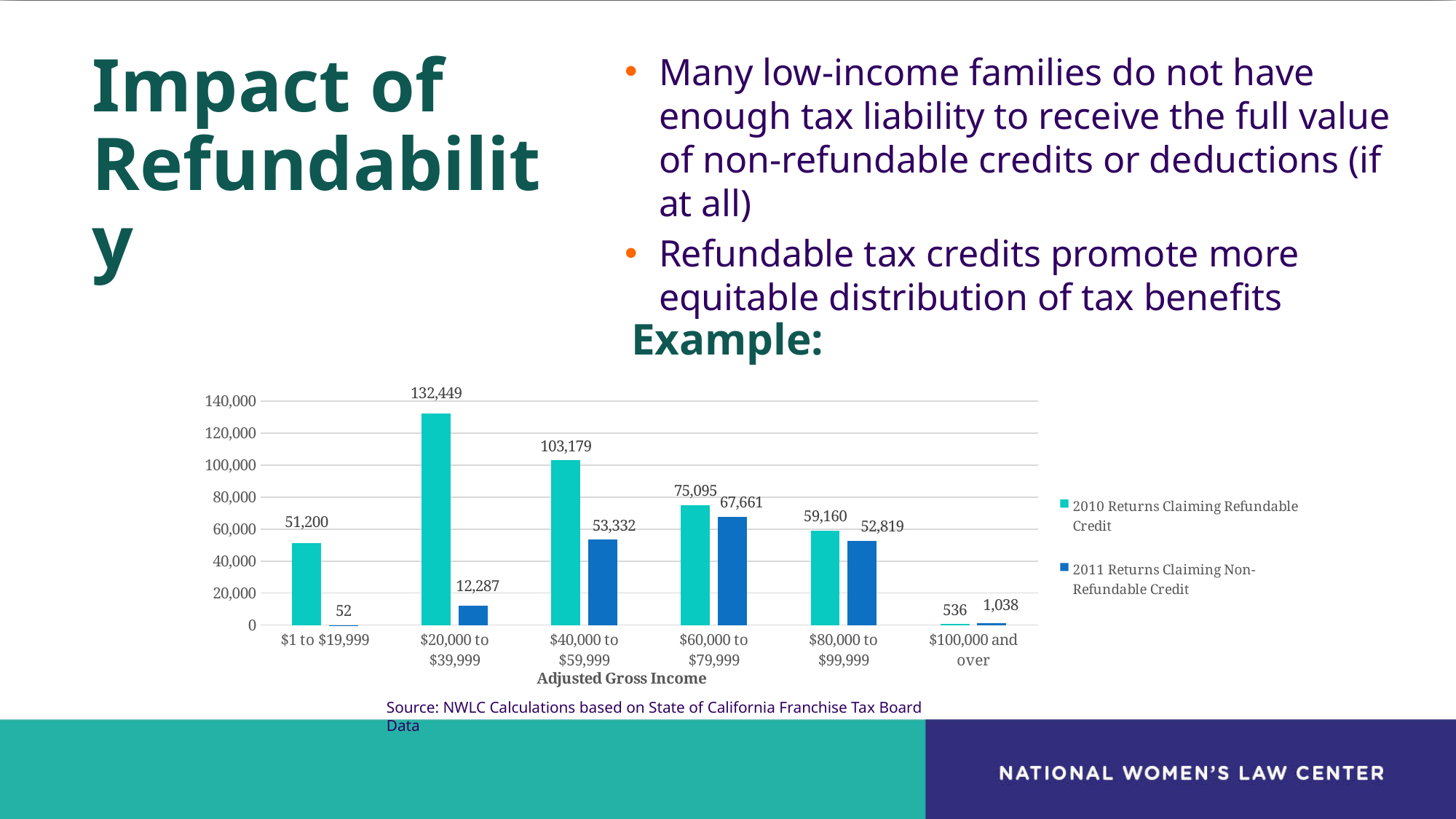
What is the value for 2011 Returns Claiming Non-Refundable Credit in the $1 to $19,999 income group? 52 How many series does the legend list? 2 Which income group has the highest value for 2010 Returns Claiming Refundable Credit? $20,000 to $39,999 What kind of chart is shown on the slide? bar chart What is the difference between 2010 Returns Claiming Refundable Credit and 2011 Returns Claiming Non-Refundable Credit in the $40,000 to $59,999 income group? 49,847 What is the value for 2010 Returns Claiming Refundable Credit in the $20,000 to $39,999 income group? 132,449 What is the value for 2011 Returns Claiming Non-Refundable Credit in the $60,000 to $79,999 income group? 67,661 In the $100,000 and over income group, which series has the larger value? 2011 Returns Claiming Non-Refundable Credit Which income group has the lowest value for 2011 Returns Claiming Non-Refundable Credit? $1 to $19,999 What is the x-axis title of the chart? Adjusted Gross Income How many income groups are shown on the x axis? 6 Is the value for 2010 Returns Claiming Refundable Credit in the $80,000 to $99,999 group greater or less than 60,000? less